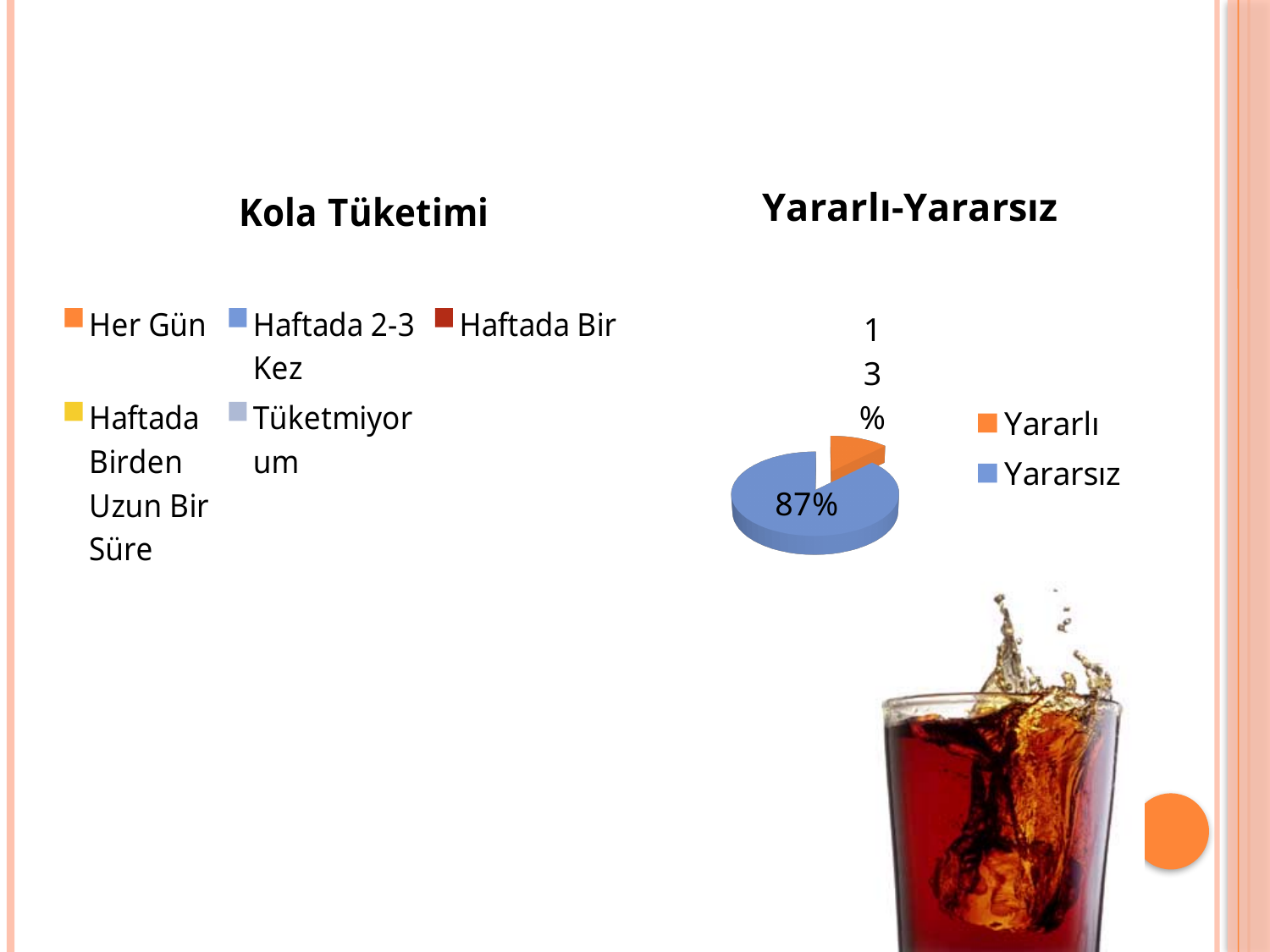
In the Yararlı-Yararsız chart, what percentage is shown for Yararsız? 87% In the Yararlı-Yararsız chart, what colour is the Yararsız slice? Blue In the Yararlı-Yararsız chart, which is larger, Yararlı or Yararsız? Yararsız In the Yararlı-Yararsız chart, what percentage is shown for Yararlı? 13% How many entries does the legend of the Kola Tüketimi chart list? 5 In the Yararlı-Yararsız chart, which category has the smallest slice? Yararlı How many entries does the legend of the Yararlı-Yararsız chart list? 2 How many slices does the Yararlı-Yararsız pie chart have? 2 What type of chart is the Yararlı-Yararsız chart? Pie chart What is the title of the chart on the left side of the slide? Kola Tüketimi In the Yararlı-Yararsız chart, what is the difference in percentage points between Yararsız and Yararlı? 74 percentage points In the Yararlı-Yararsız chart, which category has the largest slice? Yararsız